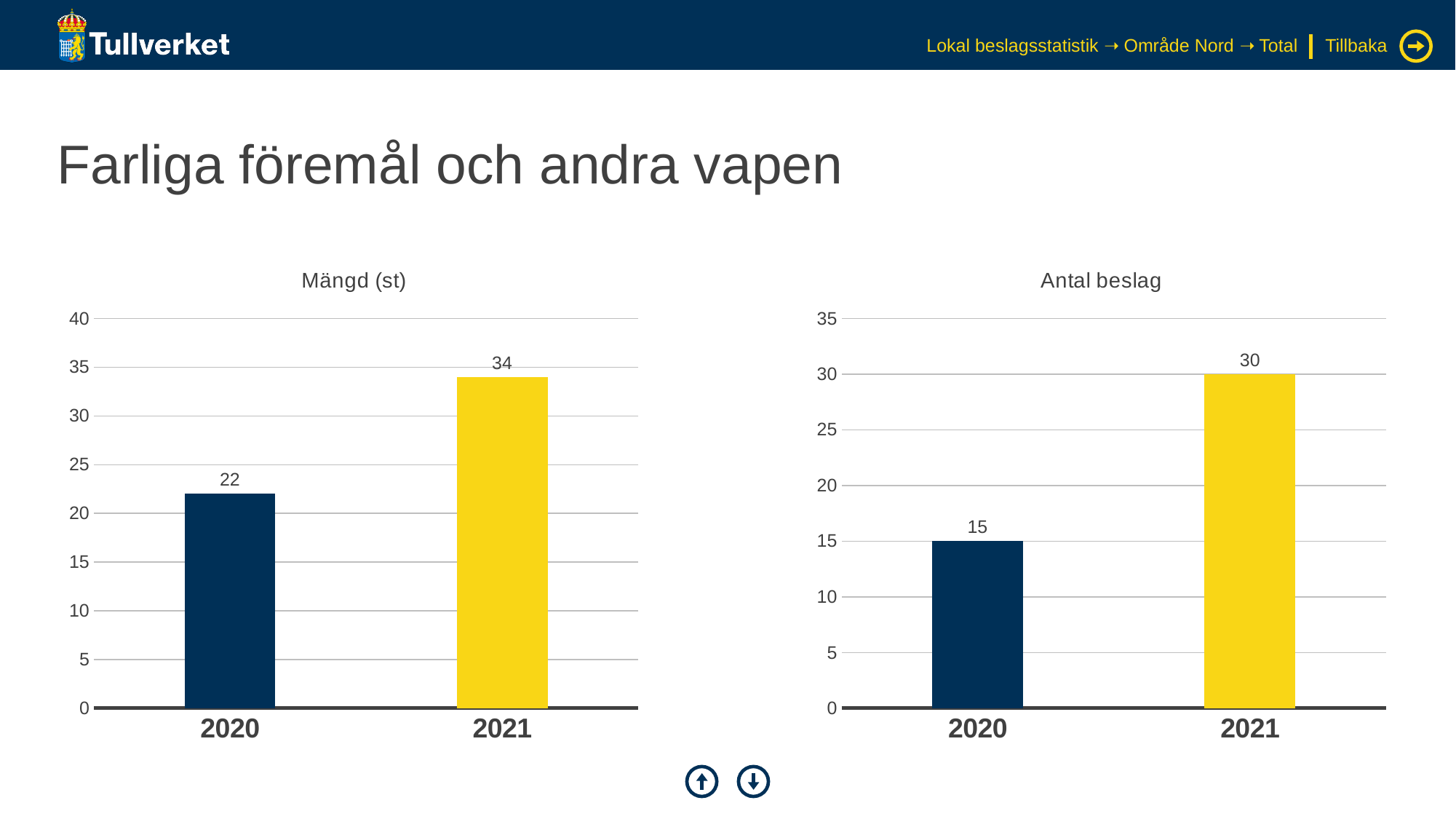
In the 'Mängd (st)' chart, which year has the highest value? 2021 In the 'Antal beslag' chart, what is the difference between the values for 2021 and 2020? 15 In the 'Antal beslag' chart, is the value for 2021 greater or less than 25? greater In the 'Antal beslag' chart, what is the value for 2021? 30 What kind of chart is the 'Antal beslag' chart? Bar chart In the 'Mängd (st)' chart, what is the value for 2020? 22 In the 'Antal beslag' chart, which year has the lowest value? 2020 In the 'Mängd (st)' chart, what is the difference between the values for 2021 and 2020? 12 In the 'Antal beslag' chart, what is the value for 2020? 15 How many categories are shown in the 'Mängd (st)' chart? 2 In the 'Mängd (st)' chart, what is the value for 2021? 34 In the 'Mängd (st)' chart, do the values rise or fall from 2020 to 2021? Rise